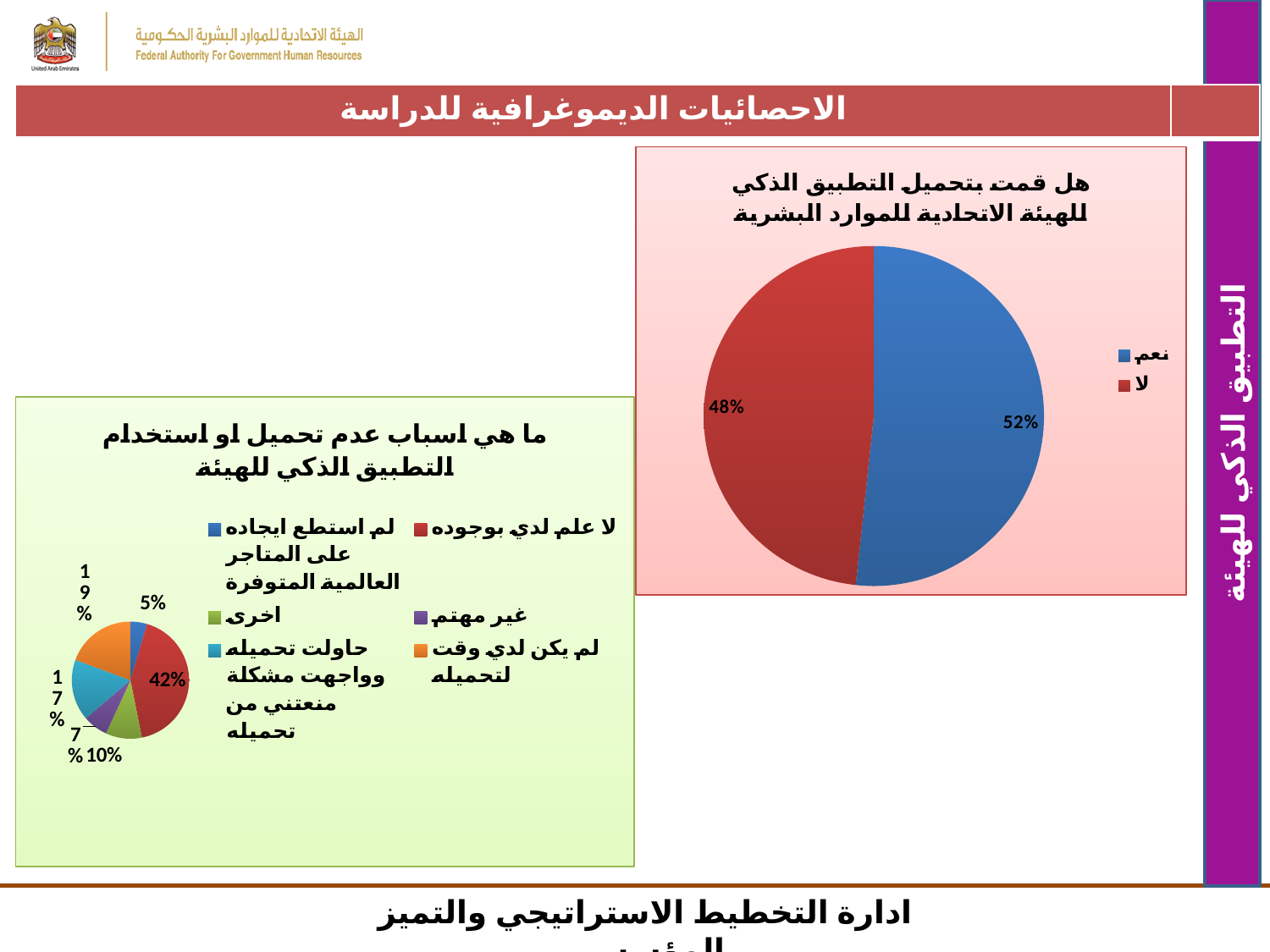
How many categories does the legend of the right-hand pie chart (هل قمت بتحميل التطبيق الذكي) list? 2 In the left-hand pie chart (اسباب عدم تحميل او استخدام التطبيق الذكي), which reason has the smallest share? لم استطع ايجاده على المتاجر العالمية المتوفرة In the left-hand pie chart (ما هي اسباب عدم تحميل او استخدام التطبيق الذكي للهيئة), what percentage is shown for لا علم لدي بوجوده? 42% In the left-hand pie chart (اسباب عدم تحميل او استخدام التطبيق الذكي), which reason has the largest share? لا علم لدي بوجوده In the right-hand pie chart (هل قمت بتحميل التطبيق الذكي للهيئة الاتحادية للموارد البشرية), what percentage answered نعم? 52% In the right-hand pie chart (هل قمت بتحميل التطبيق الذكي), what is the difference in percentage points between نعم and لا? 4 percentage points What type of chart is used for the question ما هي اسباب عدم تحميل او استخدام التطبيق الذكي للهيئة? Pie chart How many categories does the legend of the left-hand pie chart (اسباب عدم تحميل او استخدام التطبيق الذكي) list? 6 In the left-hand pie chart (اسباب عدم تحميل او استخدام التطبيق الذكي), what percentage is shown for غير مهتم? 7% In the right-hand pie chart (هل قمت بتحميل التطبيق الذكي), what percentage answered لا? 48% In the left-hand pie chart (اسباب عدم تحميل او استخدام التطبيق الذكي), what percentage is shown for لم يكن لدي وقت لتحميله? 19% In the right-hand pie chart (هل قمت بتحميل التطبيق الذكي), which answer has the larger share, نعم or لا? نعم